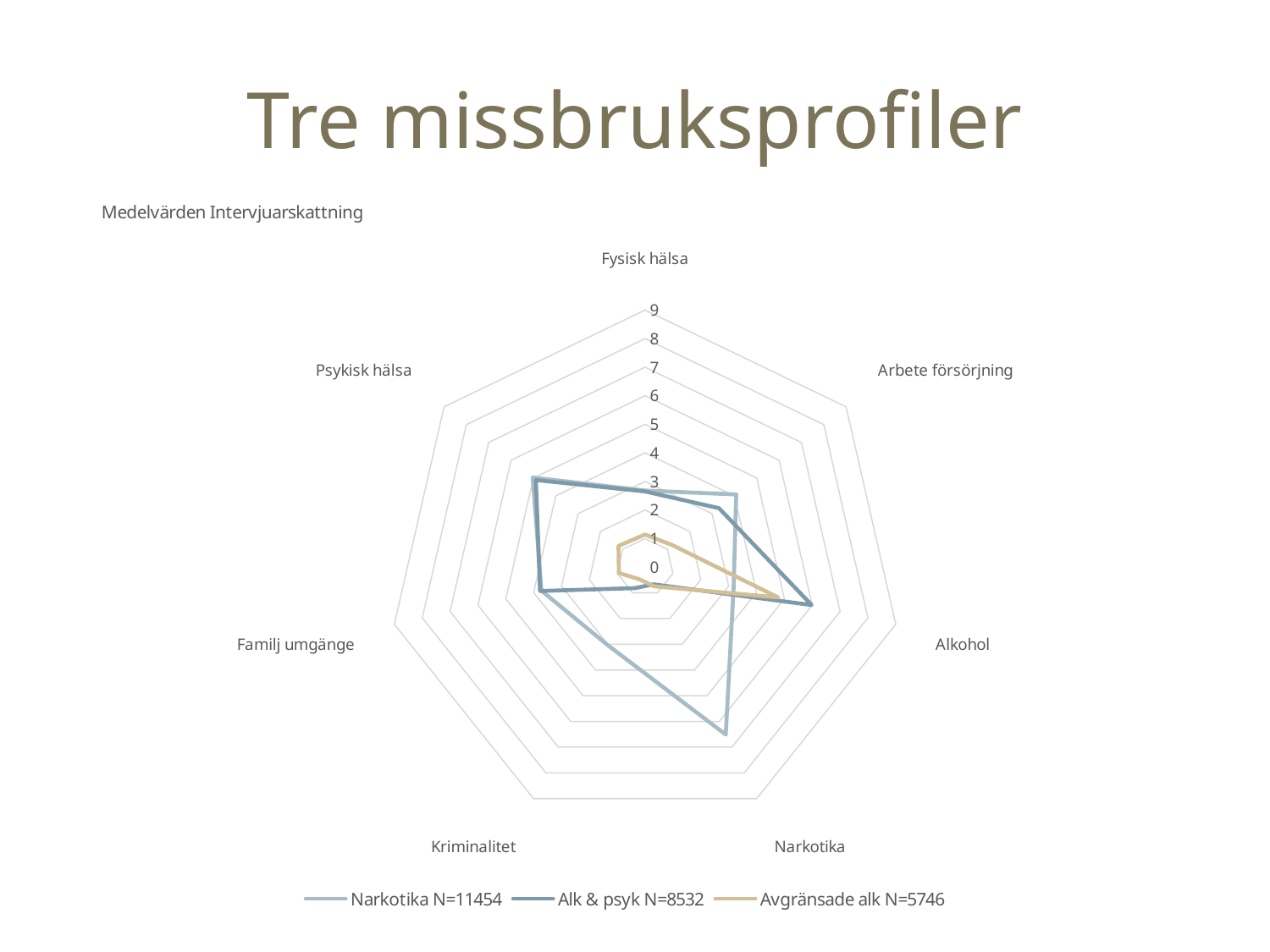
How many categories (axes) does the radar chart have? 7 Is the value for Narkotika in the Narkotika N=11454 series greater or less than 5? greater How many series does the legend list? 3 In which category does the Narkotika N=11454 series reach its highest value? Narkotika Is the value for Alkohol in the Avgränsade alk N=5746 series greater or less than 3? greater In which category does the Avgränsade alk N=5746 series reach its highest value? Alkohol For the Alkohol category, which series has the larger value: Alk & psyk N=8532 or Narkotika N=11454? Alk & psyk N=8532 Is the value for Alkohol in the Alk & psyk N=8532 series greater or less than 4? greater What is the title of the slide containing the chart? Tre missbruksprofiler What kind of chart is shown on the slide? Radar chart What are the three series named in the legend? Narkotika N=11454, Alk & psyk N=8532, Avgränsade alk N=5746